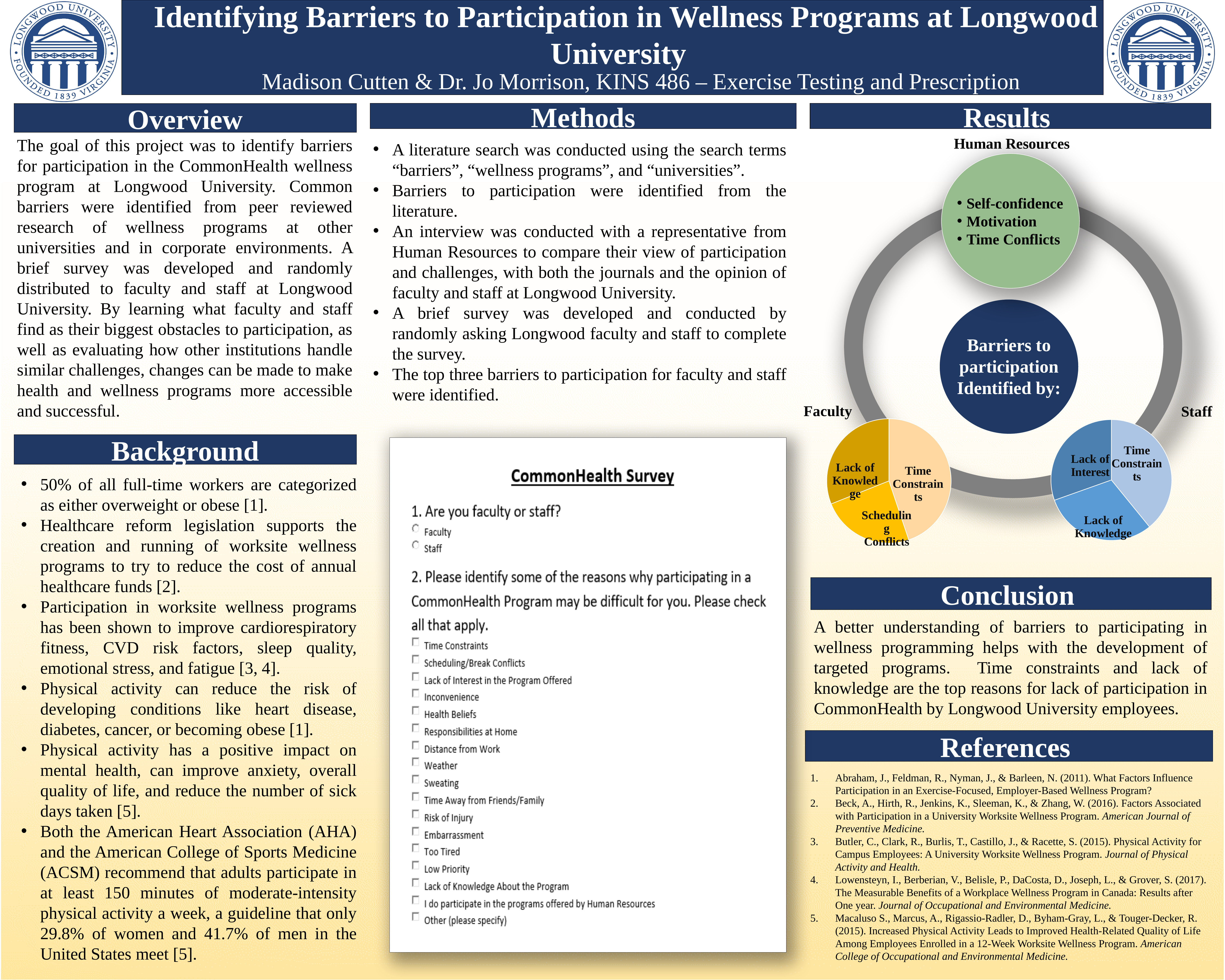
Which barrier appears in the Staff pie chart but not in the Faculty pie chart? Lack of Interest In the Staff pie chart, which is larger: Time Constraints or Lack of Interest? Time Constraints How many slices does the Staff pie chart have? 3 What kind of chart is the Faculty chart? pie chart What kind of chart is the Staff chart? pie chart How many slices does the Faculty pie chart have? 3 In the Faculty pie chart, which is larger: Time Constraints or Lack of Knowledge? Time Constraints In the Faculty pie chart, which is larger: Time Constraints or Scheduling Conflicts? Time Constraints How many pie charts are shown in the Results section? 2 In the Faculty pie chart, which barrier has the largest slice? Time Constraints Which barrier appears in the Faculty pie chart but not in the Staff pie chart? Scheduling Conflicts